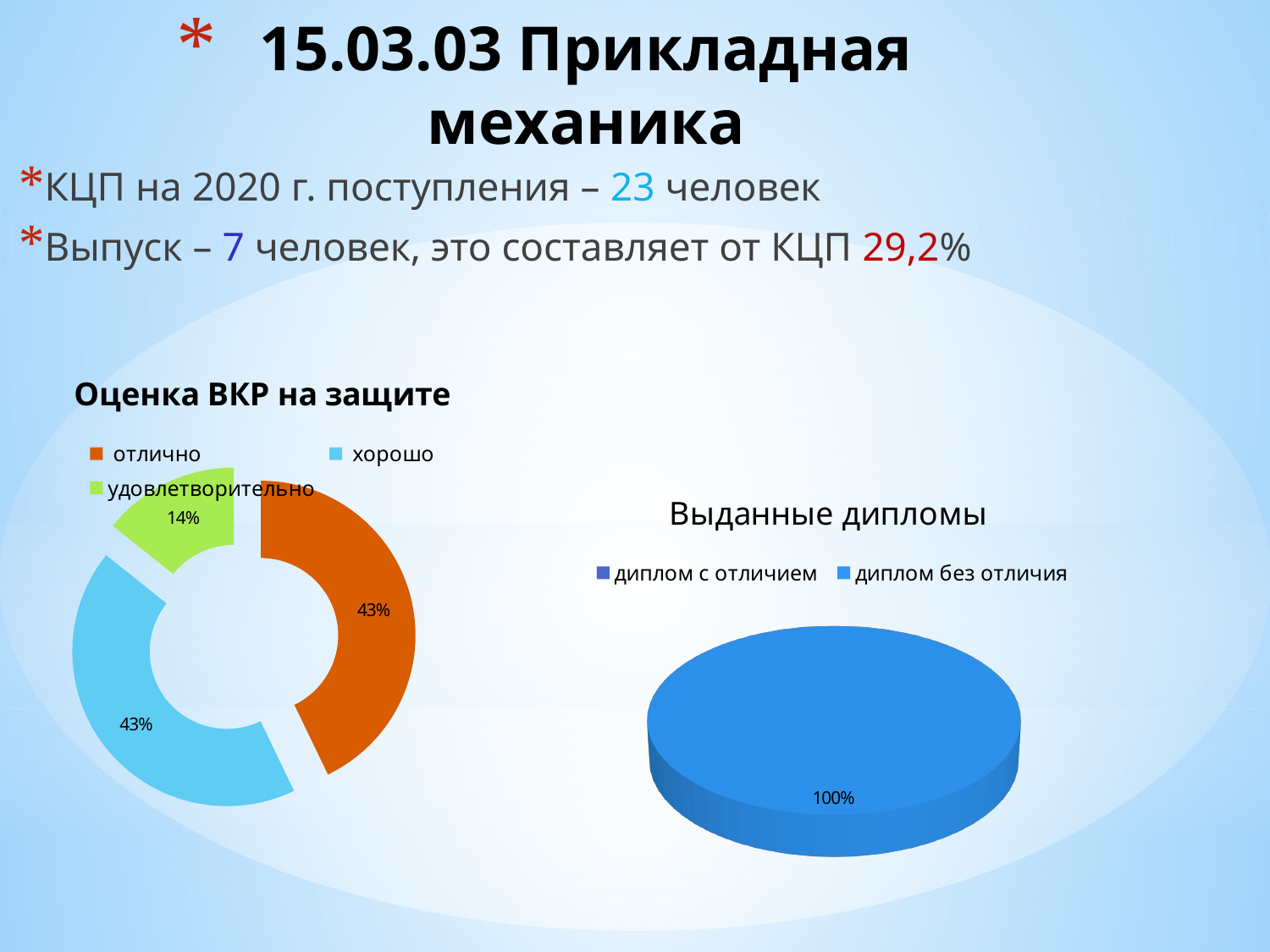
In the chart titled "Выданные дипломы", how many categories does the legend list? 2 In the chart titled "Оценка ВКР на защите", what share is labelled for "хорошо"? 43% In the chart titled "Оценка ВКР на защите", which category has the smallest share? удовлетворительно In the chart titled "Оценка ВКР на защите", what share is labelled for "удовлетворительно"? 14% In the chart titled "Оценка ВКР на защите", how many categories does the legend list? 3 In the chart titled "Оценка ВКР на защите", what colour is the "отлично" segment? orange In the chart titled "Выданные дипломы", what share is labelled on the pie? 100% In the chart titled "Оценка ВКР на защите", what share is labelled for "отлично"? 43% What kind of chart is the one titled "Выданные дипломы"? pie chart In the chart titled "Оценка ВКР на защите", what is the difference between the shares for "отлично" and "удовлетворительно"? 29% In the chart titled "Оценка ВКР на защите", which is larger: the share for "хорошо" or for "удовлетворительно"? хорошо What kind of chart is the one titled "Оценка ВКР на защите"? doughnut chart